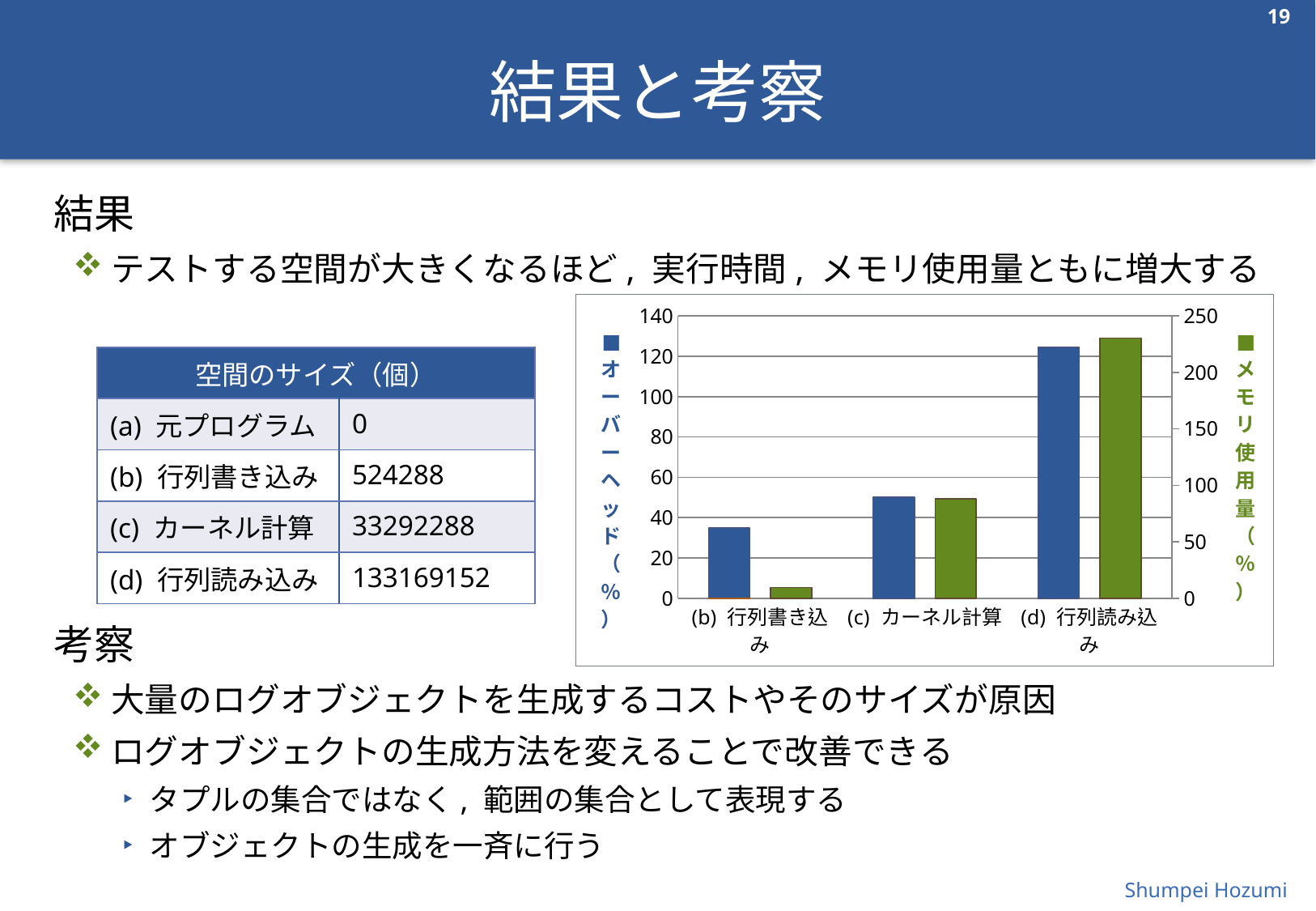
Which has the larger オーバーヘッド（%） value, (b) 行列書き込み or (c) カーネル計算? (c) カーネル計算 Is the メモリ使用量（%） value for (d) 行列読み込み greater or less than 200? greater What kind of chart is shown on the slide? bar chart Is the オーバーヘッド（%） value for (d) 行列読み込み greater or less than 100? greater How many categories are plotted on the x axis of the chart? 3 Do the オーバーヘッド（%） values rise or fall from (b) to (d) along the x axis? rise Is the メモリ使用量（%） value for (b) 行列書き込み greater or less than 50? less How many series does the chart show? 2 Which category has the highest メモリ使用量（%） value? (d) 行列読み込み Which category has the highest オーバーヘッド（%） value? (d) 行列読み込み Which category has the lowest メモリ使用量（%） value? (b) 行列書き込み